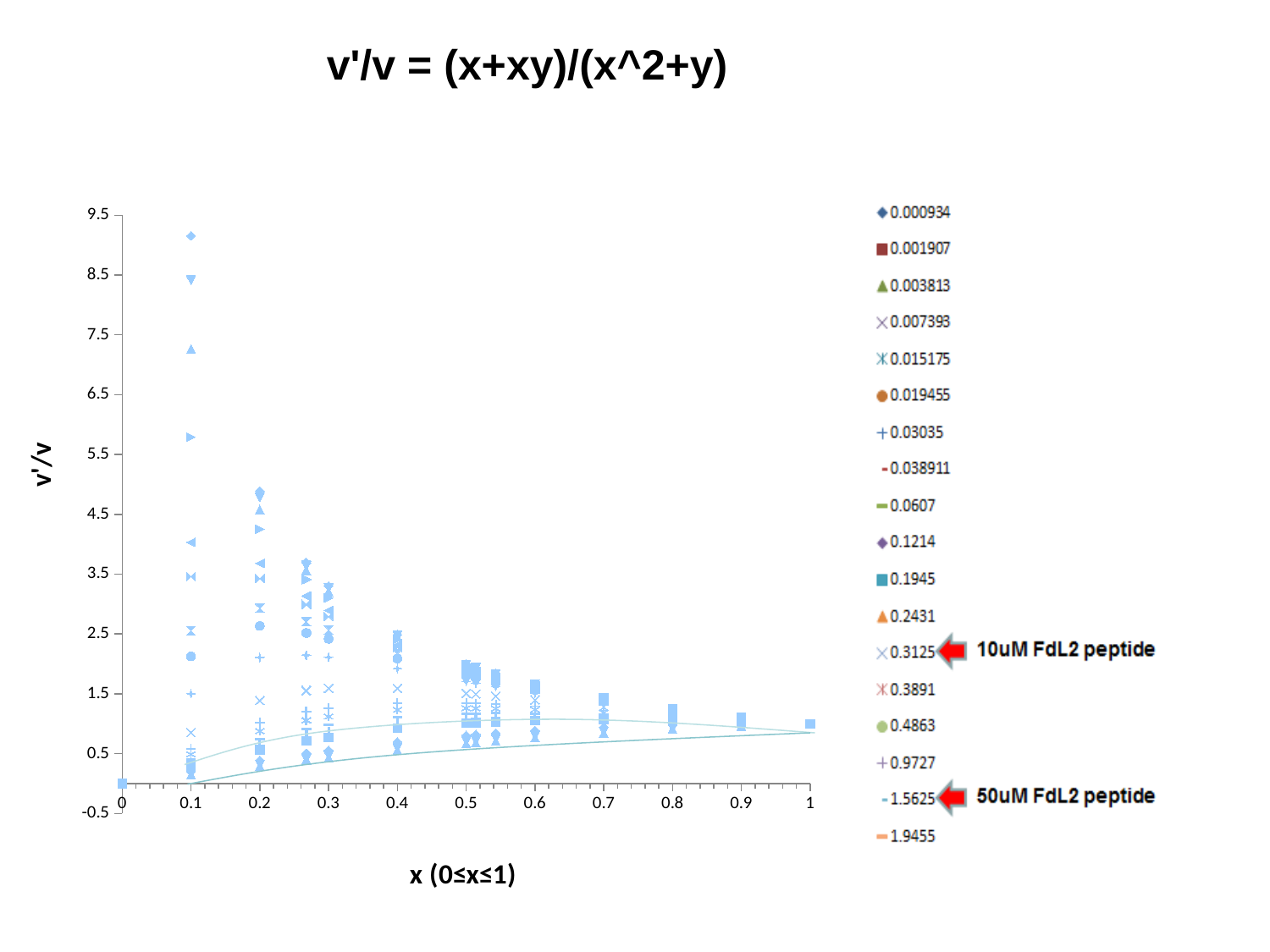
What is the highest tick value shown on the y axis? 9.5 What is the last (bottom) entry in the legend? 1.9455 What is the label of the y axis? v'/v Is the highest plotted point at x = 0.1 greater or less than 8.5 on the y axis? greater Which legend entry does the arrow labelled "50uM FdL2 peptide" point to? 1.5625 What is the first (top) entry in the legend? 0.000934 What kind of chart is shown on the slide? Scatter chart What is the title of the chart? v'/v = (x+xy)/(x^2+y) Which legend entry does the arrow labelled "10uM FdL2 peptide" point to? 0.3125 At which x value do the plotted points reach their highest y values? 0.1 How many series does the legend list? 18 Are the plotted points at x = 1 greater or less than 1.5 on the y axis? less